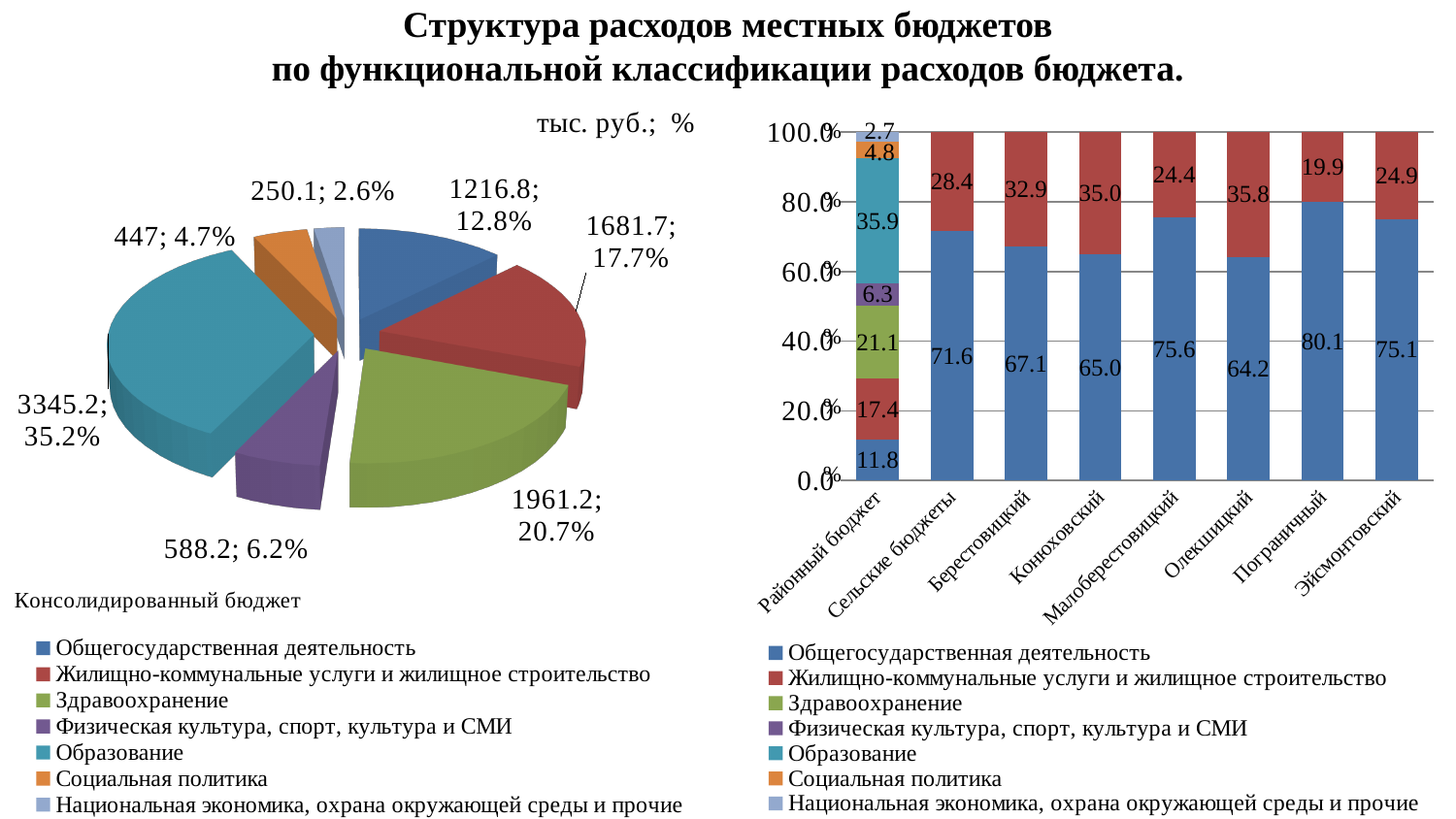
On the left pie chart (Консолидированный бюджет), what value in тыс. руб. is shown for Здравоохранение? 1961.2 On the left pie chart (Консолидированный бюджет), which category has the smallest share? Национальная экономика, охрана окружающей среды и прочие On the right stacked bar chart, what is the value of Образование for Районный бюджет? 35.9 On the left pie chart (Консолидированный бюджет), which category has the largest share? Образование On the right stacked bar chart, which is larger: Жилищно-коммунальные услуги for Олекшицкий or for Малоберестовицкий? Олекшицкий On the left pie chart (Консолидированный бюджет), what is the difference in percentage points between Здравоохранение (20.7%) and Жилищно-коммунальные услуги и жилищное строительство (17.7%)? 3.0 On the right stacked bar chart, which budget has the highest value for Общегосударственная деятельность? Пограничный On the right stacked bar chart, how many budgets are shown on the x axis? 8 On the left pie chart (Консолидированный бюджет), what is the share of Образование? 35.2% What type of chart is on the right side of the slide? Stacked bar chart On the right stacked bar chart, what is the value of Общегосударственная деятельность for Пограничный? 80.1 On the left pie chart (Консолидированный бюджет), how many slices are there? 7